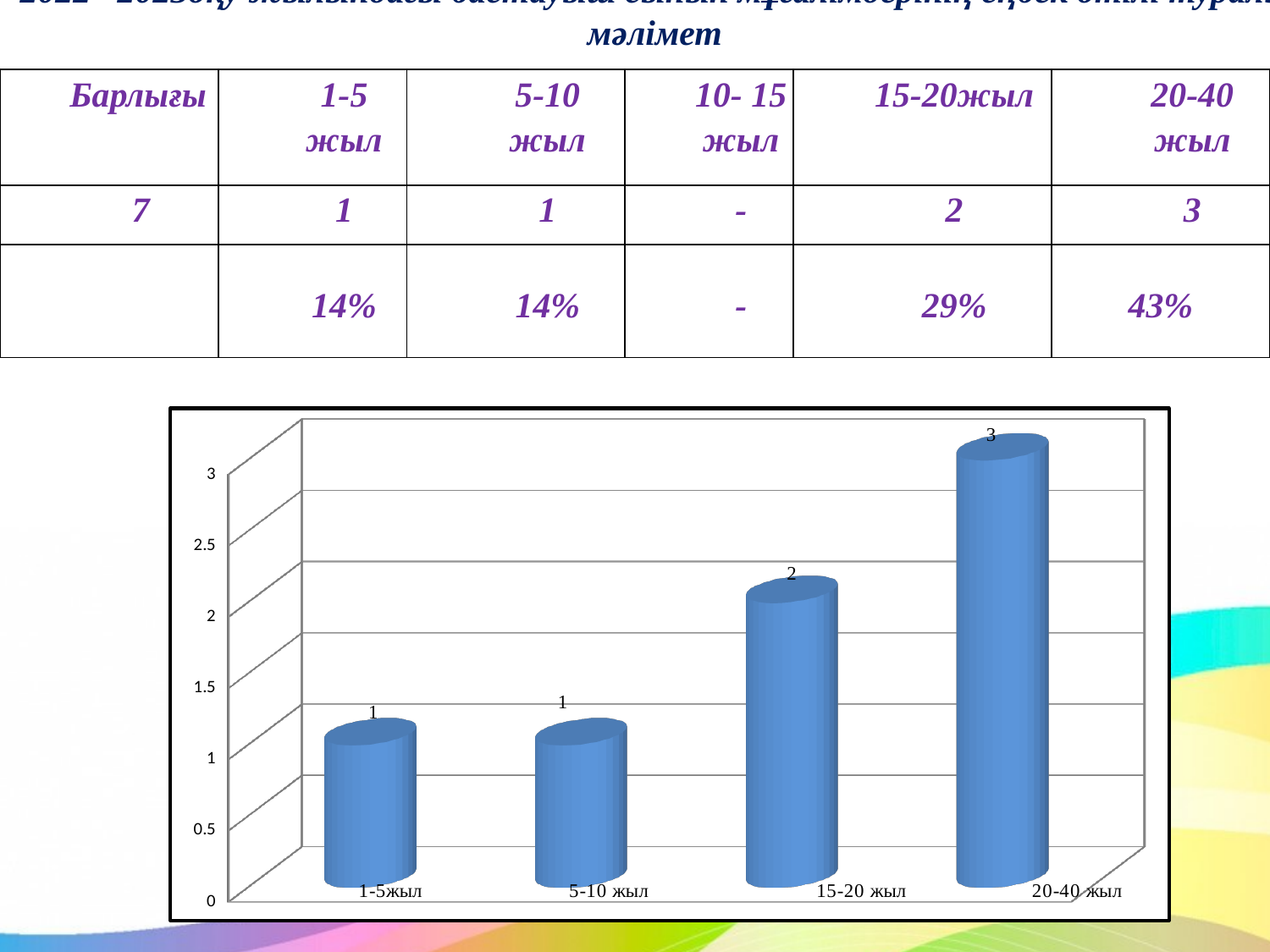
How many categories are shown on the x axis of the chart? 4 What is the value for 5-10 жыл in the chart? 1 Which category has the highest value in the chart? 20-40 жыл Do the values rise or fall from left to right along the x axis? rise What is the value for 20-40 жыл in the chart? 3 What is the value for 1-5жыл in the chart? 1 Which is larger, the value for 15-20 жыл or the value for 5-10 жыл? 15-20 жыл What is the difference between the values for 20-40 жыл and 15-20 жыл? 1 What is the value for 15-20 жыл in the chart? 2 What kind of chart is shown on the slide? bar chart What is the difference between the values for 20-40 жыл and 1-5жыл? 2 Is the value for 20-40 жыл greater or less than 2.5? greater